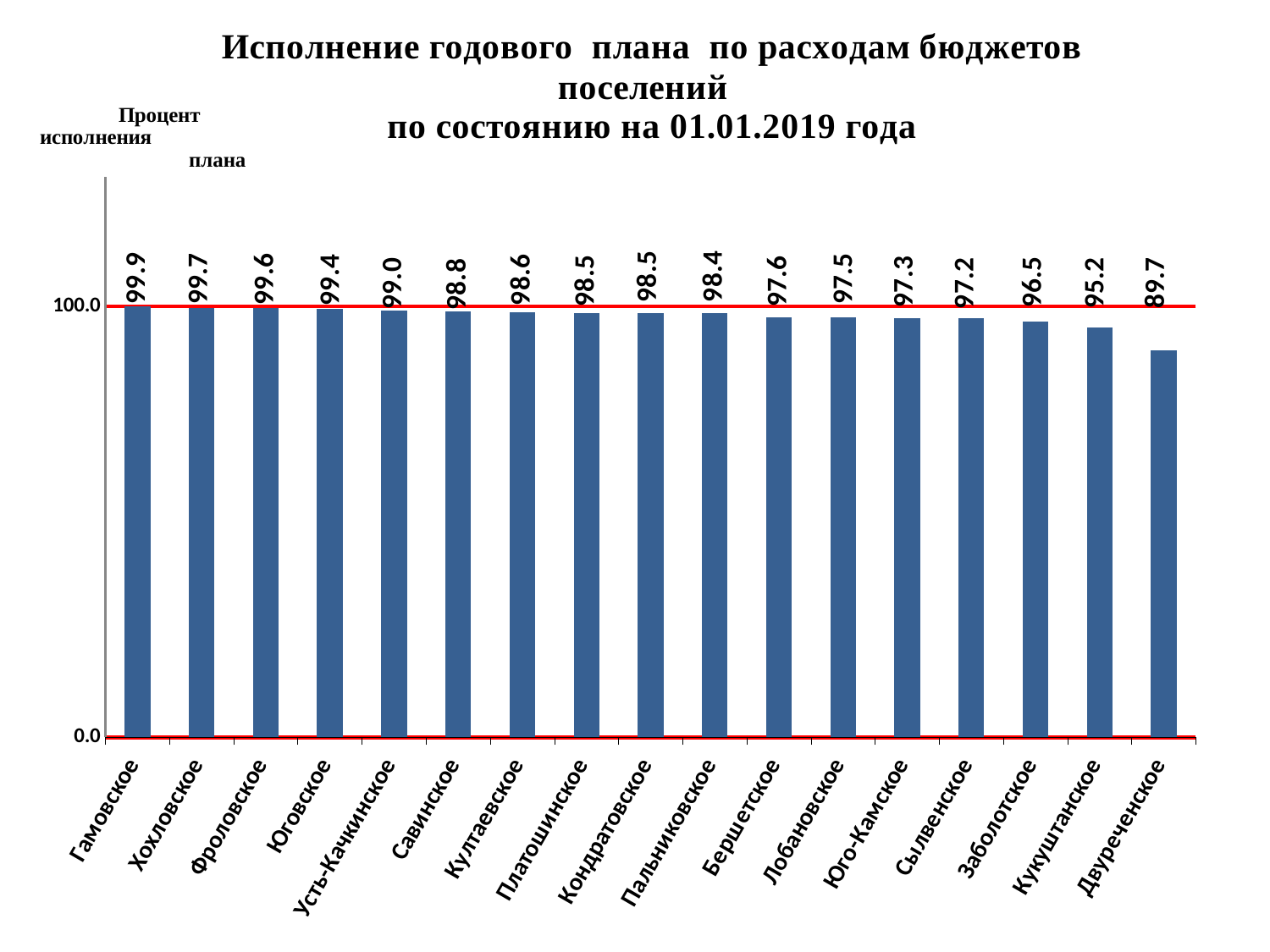
What is the difference between the values for Гамовское and Двуреченское? 10.2 What is the value for Двуреченское? 89.7 How many settlements are shown on the chart? 17 What kind of chart is shown on the slide? bar chart Which settlement has the lowest value? Двуреченское What is the value for Лобановское? 97.5 Which is larger, the value for Савинское or the value for Кукуштанское? Савинское Do the values rise or fall from left to right along the x axis? fall What is the value for Гамовское? 99.9 What is the value for Усть-Качкинское? 99.0 Is the value for Двуреченское greater or less than 100.0? less Which settlement has the highest value? Гамовское